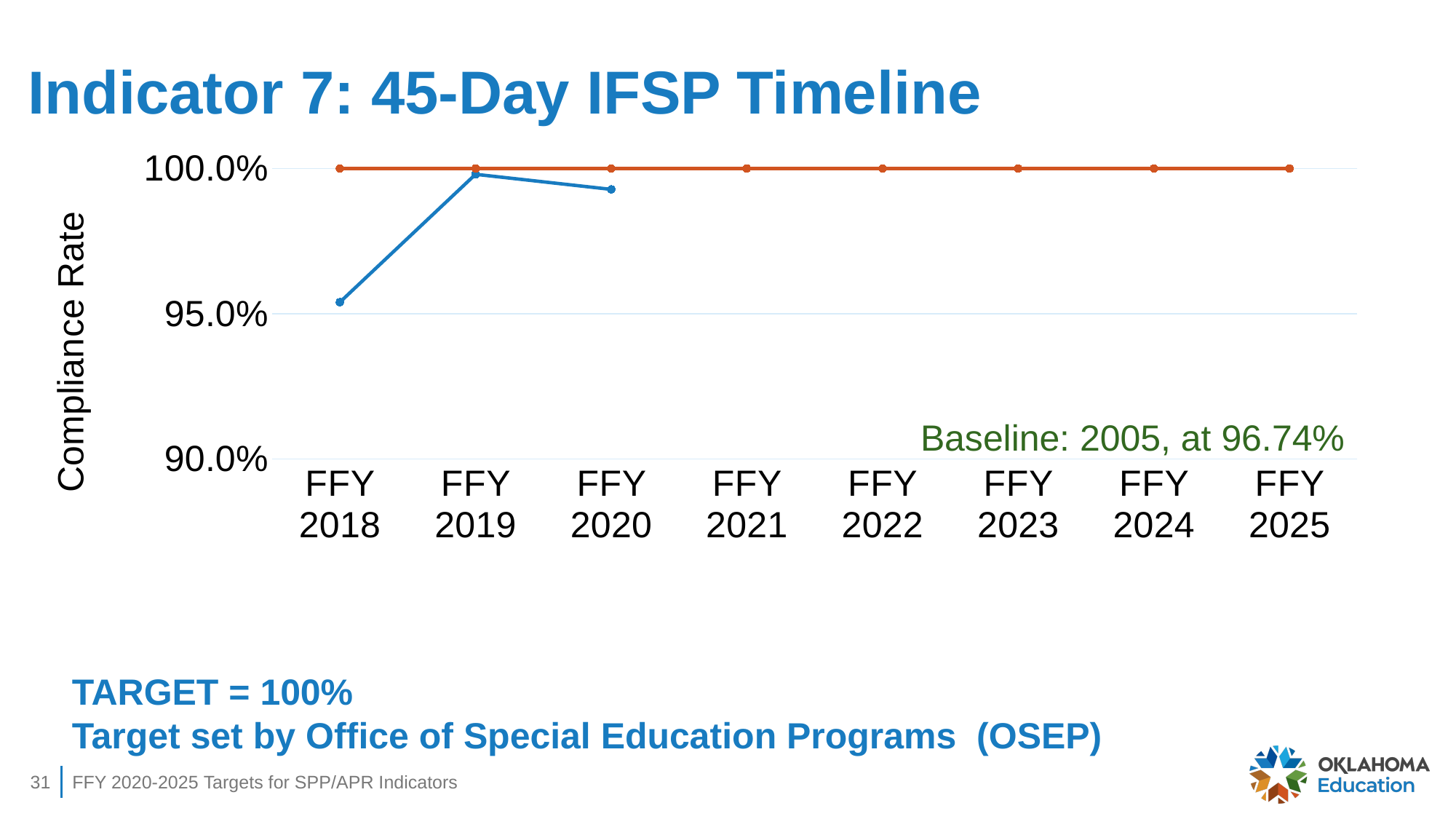
Is the blue line's value for FFY 2020 greater or less than 95.0%? greater Does the blue line rise or fall from FFY 2018 to FFY 2019? rise What kind of chart is shown on the slide? line chart Does the blue line rise or fall from FFY 2019 to FFY 2020? fall How many data points does the blue line have? 3 In which year is the blue line at its lowest? FFY 2018 Which is larger on the blue line, the value for FFY 2018 or FFY 2020? FFY 2020 What value does the orange target line sit at across all years? 100.0% In which year is the blue line at its highest? FFY 2019 How many FFY categories are shown on the x axis? 8 Is the blue line's value for FFY 2018 greater or less than 100.0%? less What is the label on the y axis of the chart? Compliance Rate